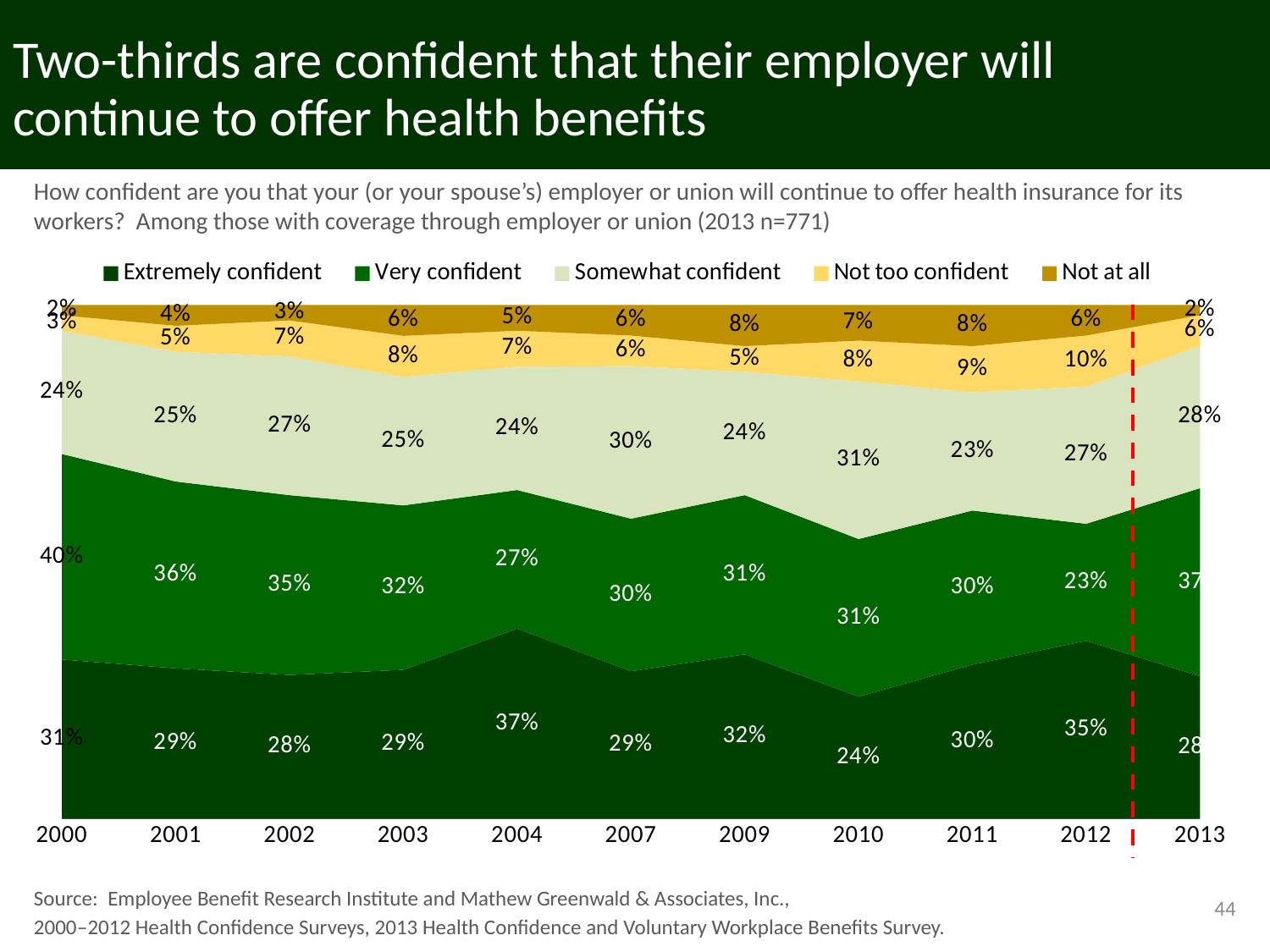
What is the Not at all value for 2009? 8% What is the Somewhat confident value for 2010? 31% What kind of chart is shown on the slide? Stacked area chart What percentage were Extremely confident in 2004? 37% How many series does the legend list? 5 By how many percentage points did the Very confident share fall from 2000 to 2012? 17 percentage points In which year was the Extremely confident share lowest? 2010 Does the Very confident share generally rise or fall from 2000 to 2012? Fall Which year had a larger Extremely confident share, 2011 or 2012? 2012 In which year was the Not too confident share highest? 2012 What percentage were Not too confident in 2012? 10% How many years are shown on the x axis? 11